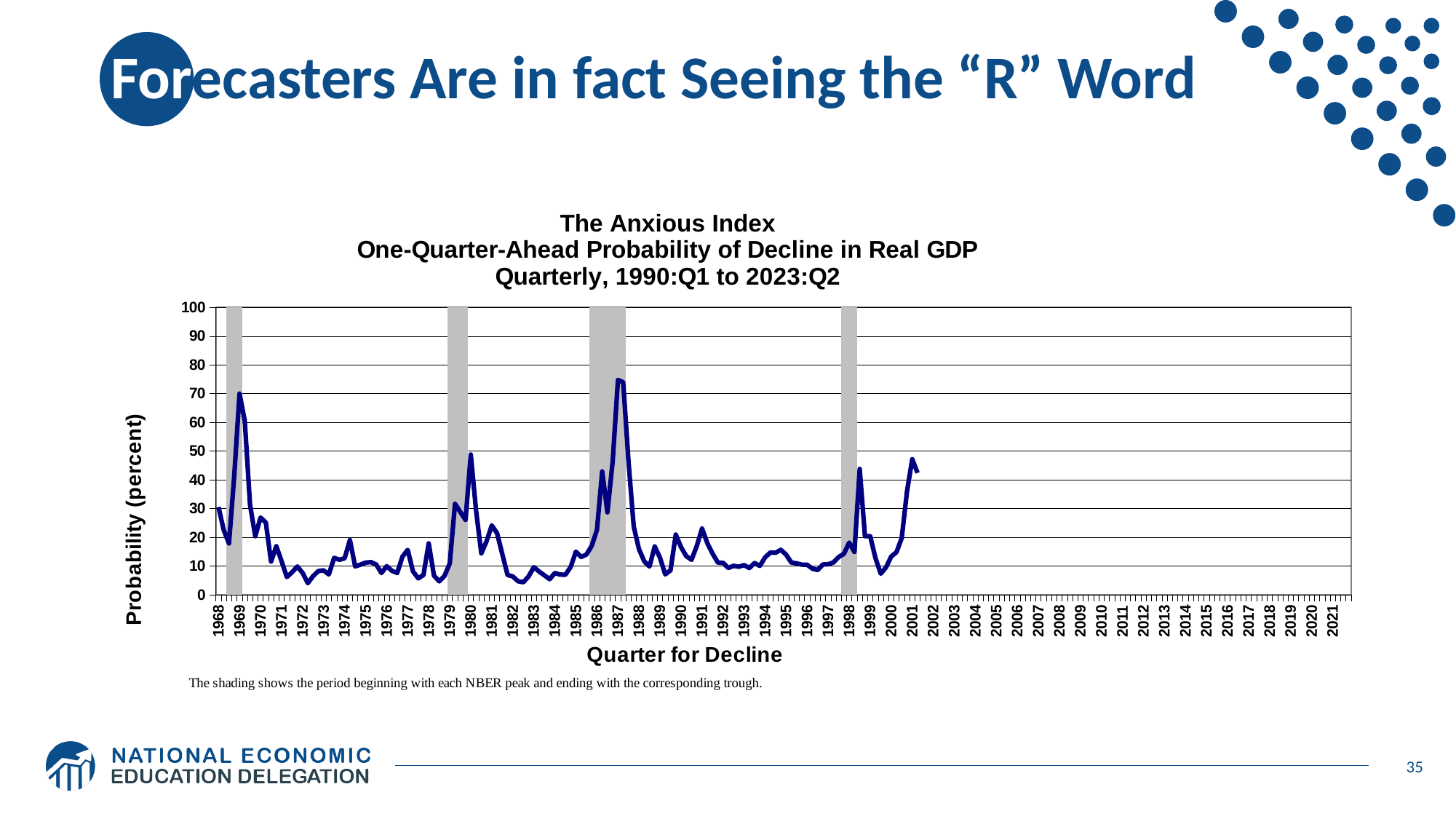
Is the peak value of the line around 1969 greater or less than 60? greater What is the title of the chart's y axis? Probability (percent) What is the highest value shown on the chart's y axis? 100 What kind of chart is shown on the slide? line chart Is the value of the line around 1996 greater or less than 20? less Is the peak value of the line around 1987 greater or less than 60? greater What is the title of the chart's x axis? Quarter for Decline Does the line rise or fall between its peak around 1987 and 1988? fall Does the line rise or fall between 2000 and 2001? rise